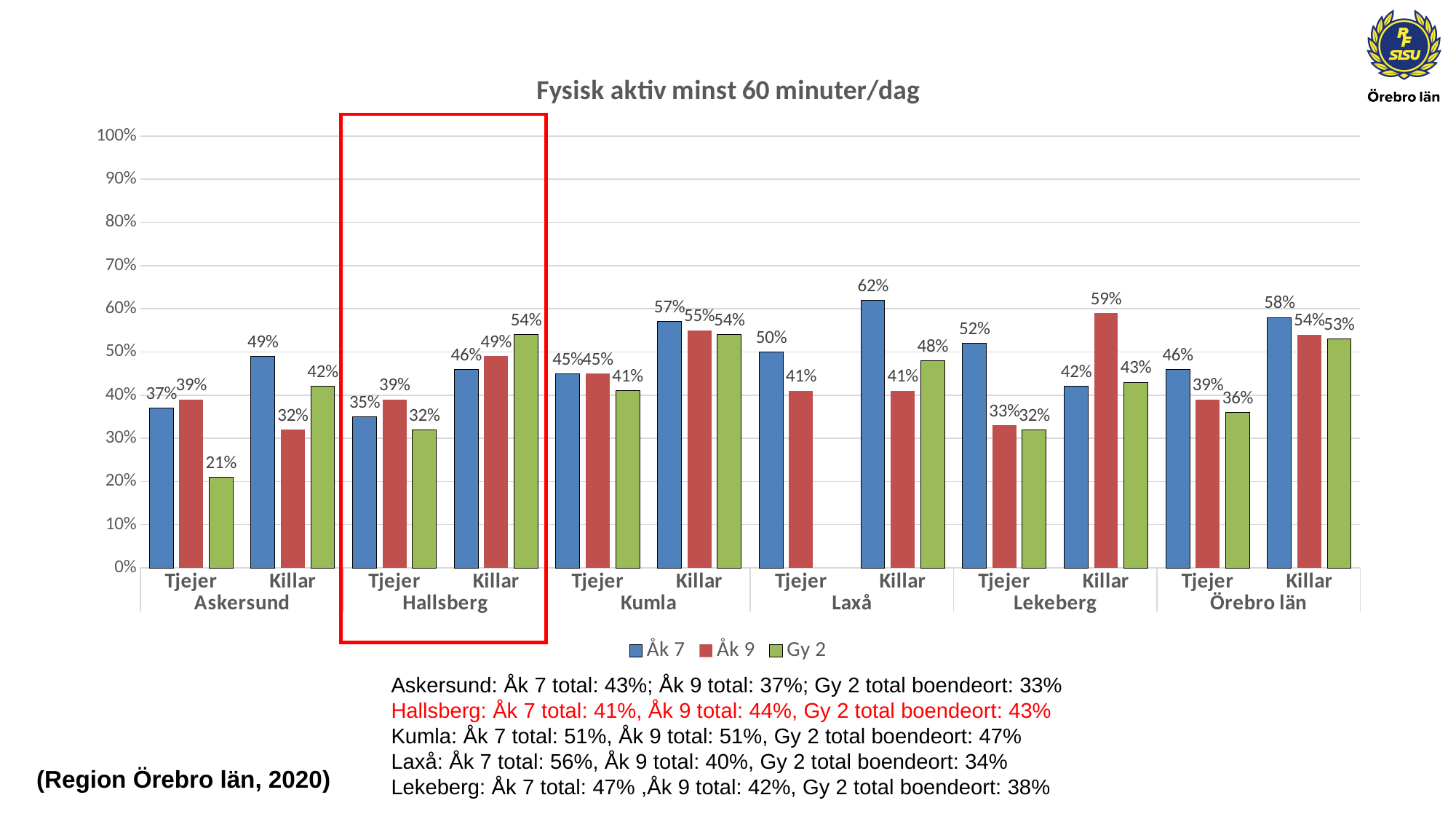
Which municipality is highlighted with a red box on the chart? Hallsberg What is the Åk 9 value for Killar in Lekeberg? 59% What is the Gy 2 value for Killar in Örebro län? 53% What is the Åk 7 value for Killar in Laxå? 62% What is the Gy 2 value for Tjejer in Askersund? 21% What is the title of the chart? Fysisk aktiv minst 60 minuter/dag How many series does the legend list? 3 What kind of chart is shown on the slide? Bar chart Which group has the highest Åk 7 value? Killar, Laxå Which is larger for Killar in Lekeberg: the Åk 7 value or the Åk 9 value? Åk 9 Which group has the lowest Gy 2 value? Tjejer, Askersund What is the difference between the Åk 7 values for Killar and Tjejer in Hallsberg? 11%